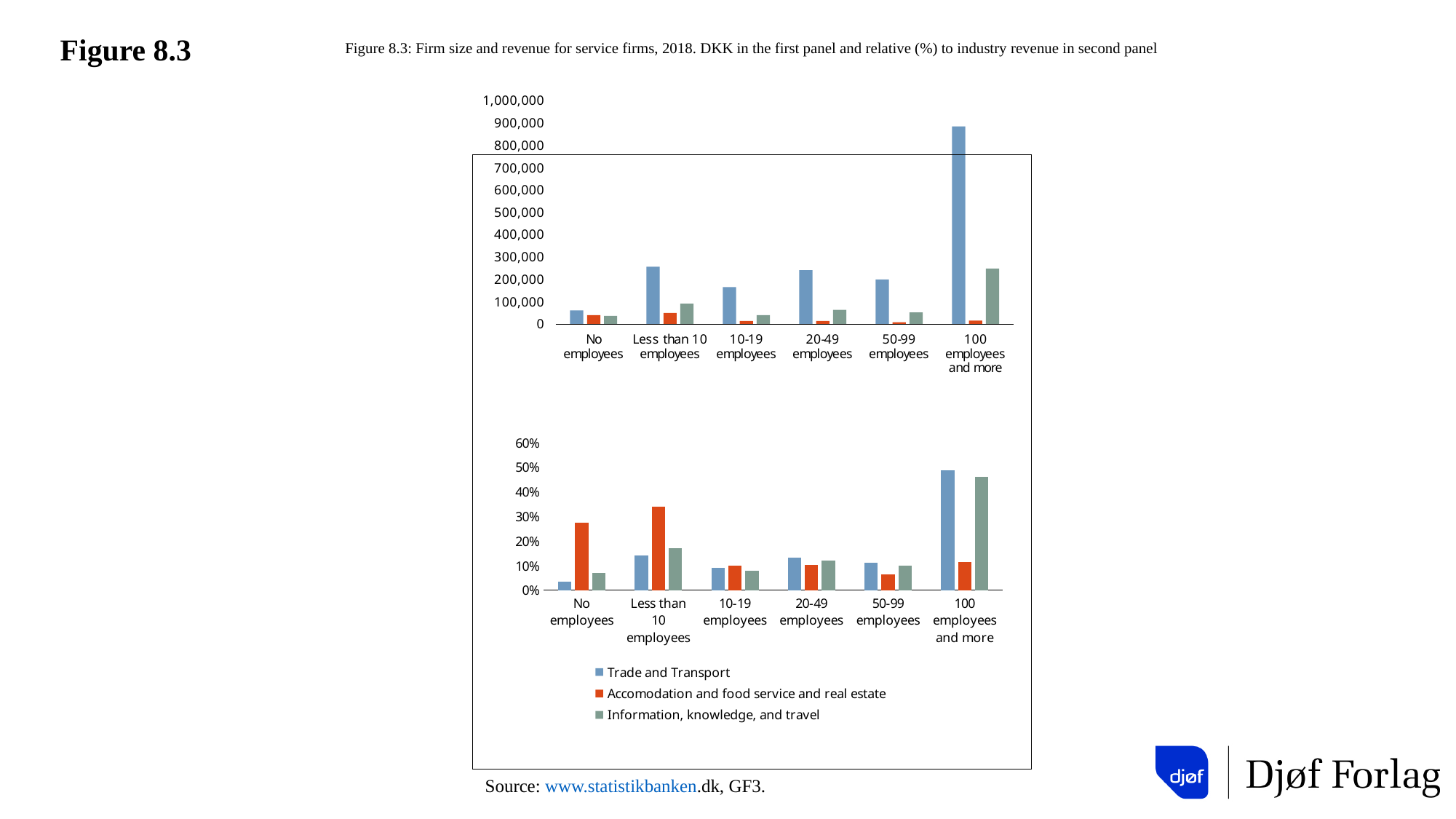
In the bottom panel, which firm-size category has the highest Accomodation and food service and real estate share? Less than 10 employees What kind of chart is the bottom panel? bar chart In the top panel, which firm-size category has the highest Trade and Transport value? 100 employees and more In the top panel, for 100 employees and more, which is larger: Trade and Transport or Information, knowledge, and travel? Trade and Transport In the bottom panel, which firm-size category has the lowest Trade and Transport share? No employees Which series is shown in orange in the legend? Accomodation and food service and real estate In the top panel, is the Trade and Transport value for 100 employees and more greater or less than 800,000? greater In the bottom panel, is the Accomodation and food service and real estate value for Less than 10 employees greater or less than 30%? greater How many firm-size categories are shown on the x axis of the top panel? 6 How many series does the legend list? 3 In the top panel, is the Information, knowledge, and travel value for 100 employees and more greater or less than 200,000? greater In the bottom panel, for No employees, which is larger: Trade and Transport or Accomodation and food service and real estate? Accomodation and food service and real estate